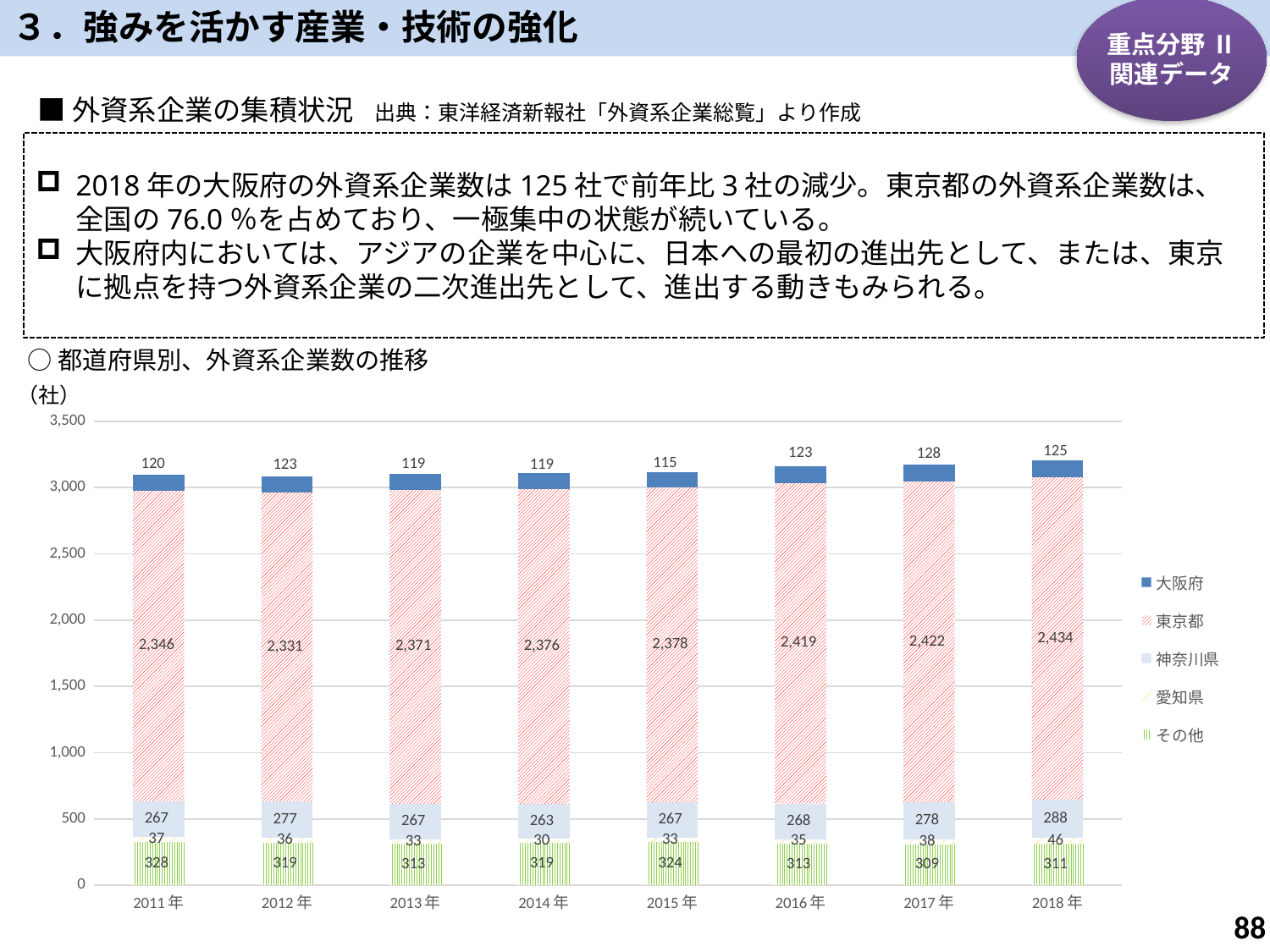
How many years are shown on the x axis? 8 What is the value for 大阪府 in 2018年? 125 What is the total of the stacked bar for 2018年? 3,204 What is the value for その他 in 2015年? 324 What is the difference between the 大阪府 values for 2017年 and 2018年? 3 Which is larger, the 愛知県 value for 2018年 or for 2011年? 2018年 In which year is the value for 大阪府 the lowest? 2015年 What is the value for 神奈川県 in 2012年? 277 In which year is the value for 大阪府 the highest? 2017年 What is the value for 東京都 in 2016年? 2,419 How many series does the legend list? 5 What kind of chart is shown? Stacked bar chart